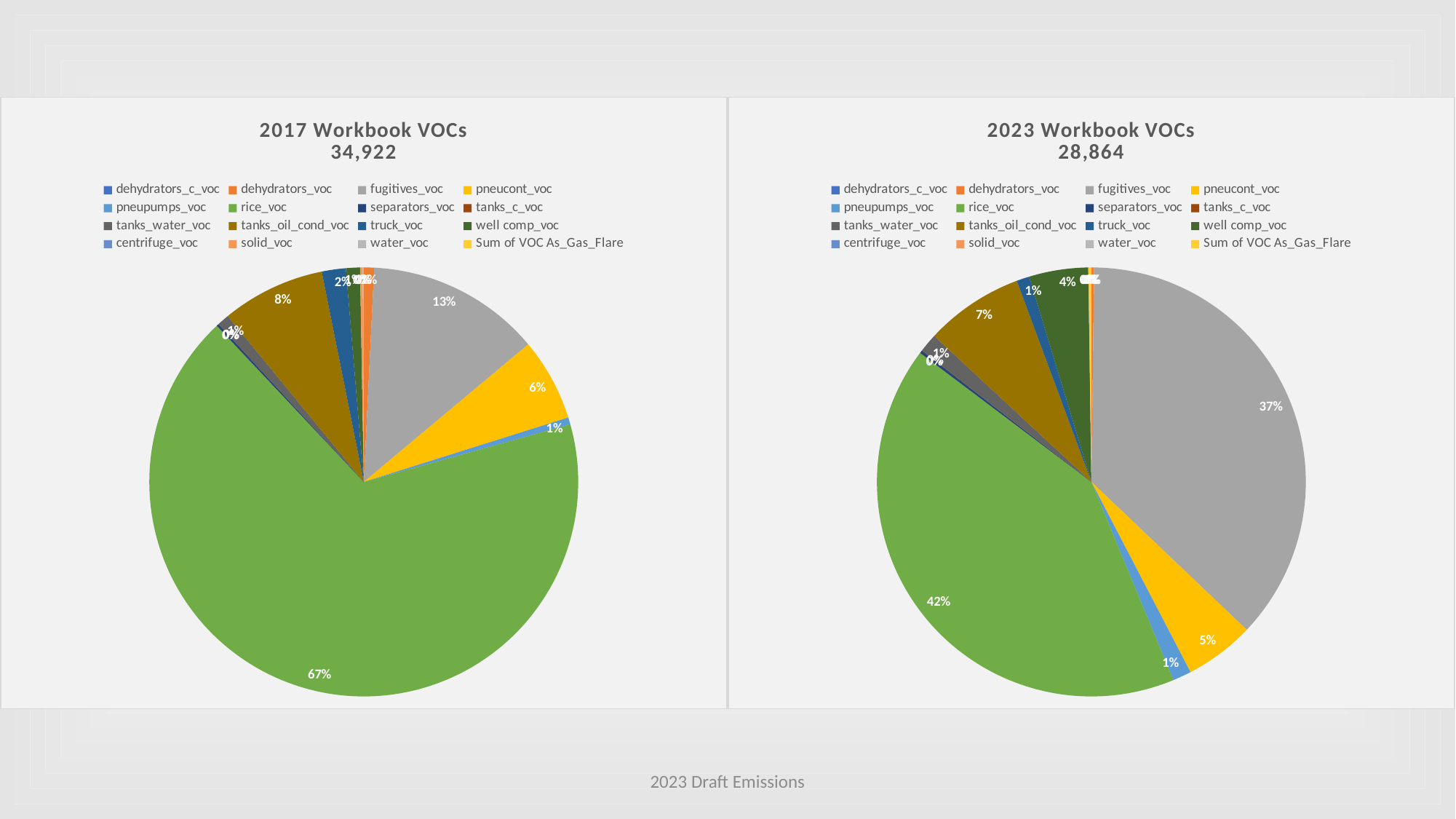
What total value is shown under the title of the 2023 Workbook VOCs chart? 28,864 Which is larger: the fugitives_voc share in the 2017 Workbook VOCs chart or in the 2023 Workbook VOCs chart? 2023 Workbook VOCs In the 2017 Workbook VOCs chart, what share of the pie is rice_voc? 67% How many entries does the legend of the 2023 Workbook VOCs chart list? 16 In the 2023 Workbook VOCs chart, what share of the pie is rice_voc? 42% In the 2023 Workbook VOCs chart, which category has the largest slice? rice_voc In the 2017 Workbook VOCs chart, what share of the pie is fugitives_voc? 13% What kind of chart is the 2017 Workbook VOCs chart? pie chart What total value is shown under the title of the 2017 Workbook VOCs chart? 34,922